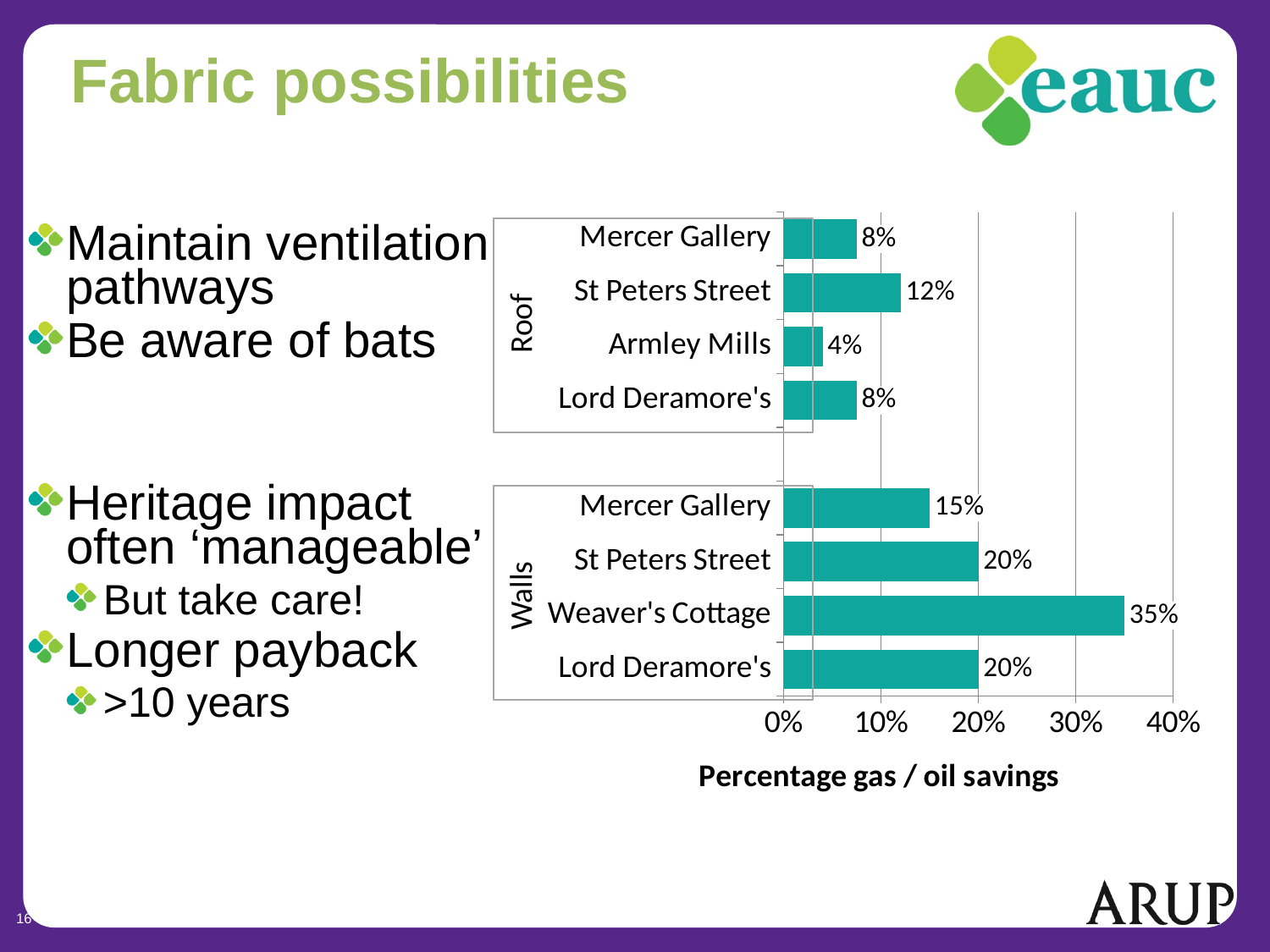
What is the percentage gas / oil savings for Weaver's Cottage in the Walls group? 35% Which is larger: the Walls savings for Mercer Gallery or the Walls savings for Lord Deramore's? Lord Deramore's Which building has the lowest percentage gas / oil savings in the Roof group? Armley Mills What is the difference between the Walls savings for Weaver's Cottage and the Walls savings for St Peters Street? 15% How many bars are plotted in the chart in total? 8 What is the difference between the Roof savings for St Peters Street and the Roof savings for Armley Mills? 8% What kind of chart is shown on the slide? Bar chart What is the percentage gas / oil savings for Mercer Gallery in the Walls group? 15% Which building has the highest percentage gas / oil savings in the Walls group? Weaver's Cottage What is the percentage gas / oil savings for St Peters Street in the Roof group? 12% What is the percentage gas / oil savings for Armley Mills in the Roof group? 4% What is the title of the horizontal axis of the chart? Percentage gas / oil savings